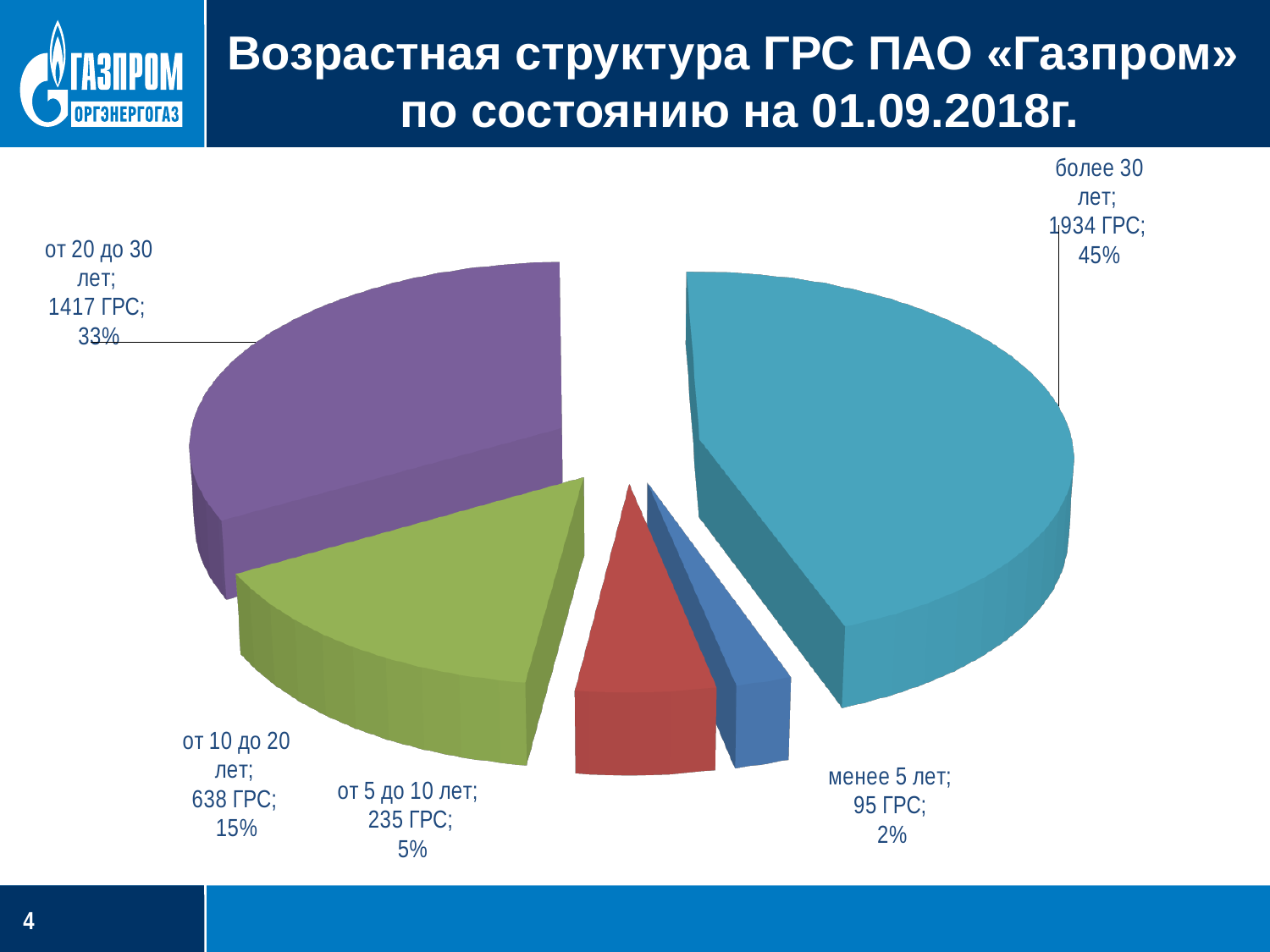
What share of the pie does the "от 20 до 30 лет" slice represent? 33% Which category has more ГРС: "от 5 до 10 лет" or "от 10 до 20 лет"? от 10 до 20 лет How many ГРС are in the "от 10 до 20 лет" category? 638 ГРС Which category has the smallest slice of the pie? менее 5 лет What is the difference in the number of ГРС between "более 30 лет" and "от 20 до 30 лет"? 517 How many slices does the pie chart have? 5 How many ГРС are in the "более 30 лет" category? 1934 ГРС What kind of chart is shown on the slide? pie chart What is the title of the chart on the slide? Возрастная структура ГРС ПАО «Газпром» по состоянию на 01.09.2018г. What is the combined percentage of the "от 5 до 10 лет" and "менее 5 лет" slices? 7% Which category has the largest slice of the pie? более 30 лет What percentage is shown for the "менее 5 лет" slice? 2%